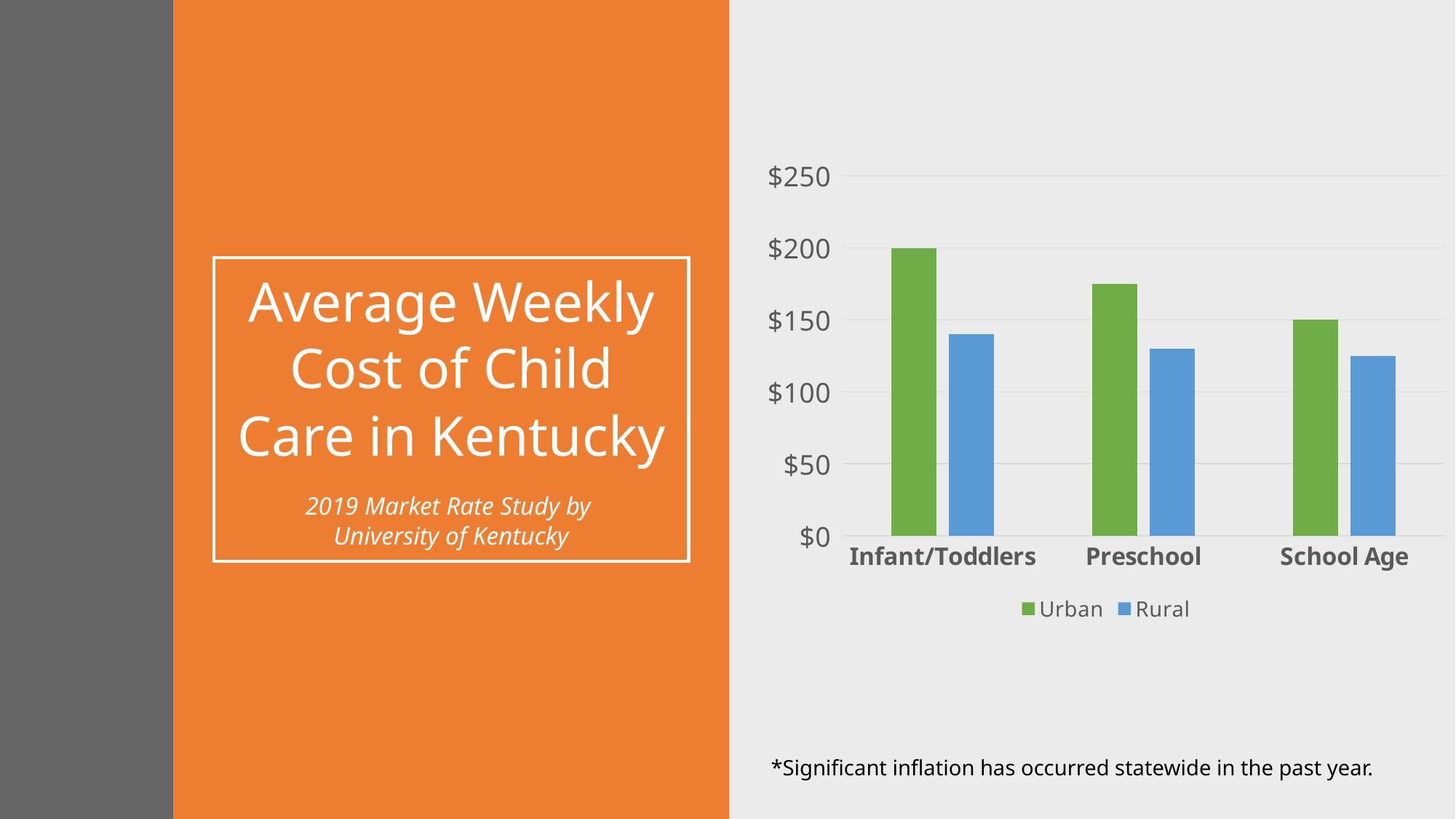
Which category has the highest Urban value? Infant/Toddlers Do the Urban values rise or fall from Infant/Toddlers to School Age? fall What kind of chart is shown on the slide? bar chart Is the Urban value for Preschool greater or less than $150? greater For Preschool, which is larger, the Urban or the Rural value? Urban Is the Rural value for Infant/Toddlers greater or less than $150? less What is the Urban value for School Age? $150 Which category has the lowest Rural value? School Age What is the Urban value for Infant/Toddlers? $200 How many age categories are shown on the x axis? 3 Is the Rural value for School Age greater or less than $100? greater How many series does the legend list? 2